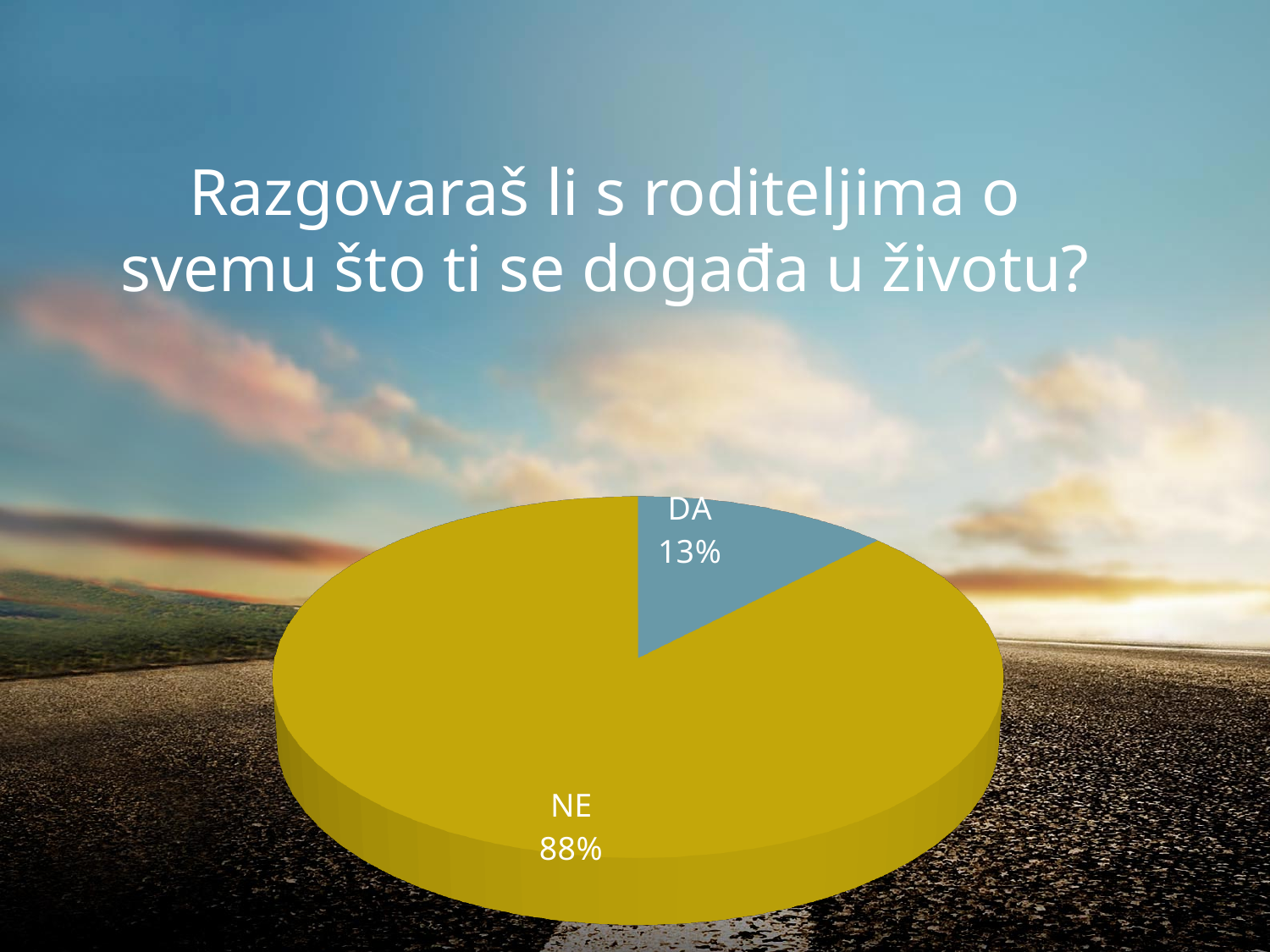
Which slice of the pie is the smallest? DA Which slice of the pie is the largest? NE What colour is the DA slice of the pie? blue What is the title of the chart on the slide? Razgovaraš li s roditeljima o svemu što ti se događa u životu? Which is larger, the DA slice or the NE slice? NE What percentage of the pie is labelled DA? 13% What percentage of the pie is labelled NE? 88% What share of the pie does the NE slice represent? 88% How many slices does the pie chart have? 2 What kind of chart is shown on the slide? pie chart What is the difference in percentage points between the NE slice and the DA slice? 75